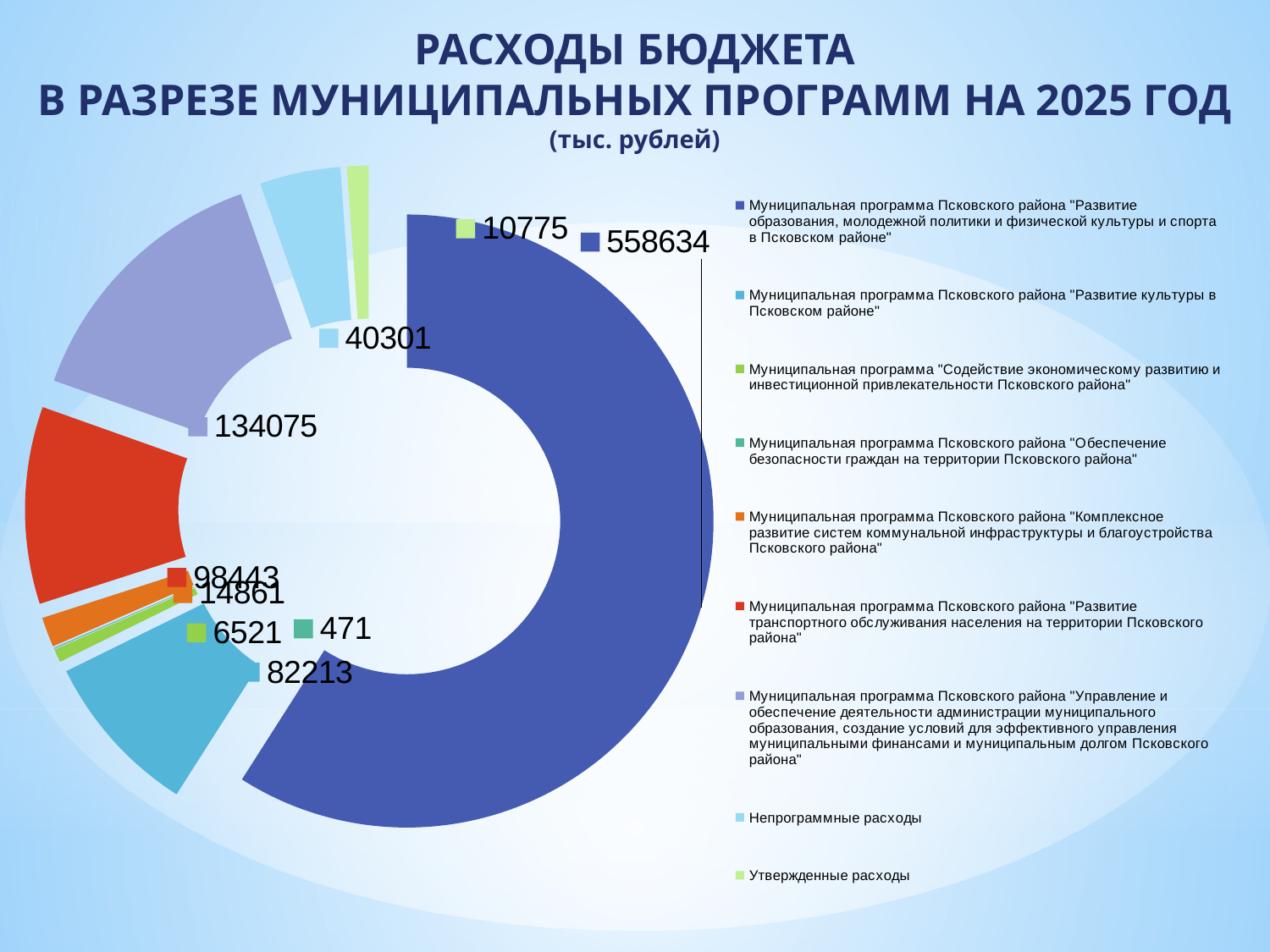
What is the value for "Непрограммные расходы"? 40301 What is the value for the municipal program "Развитие культуры в Псковском районе"? 82213 Which is larger: the value for "Развитие культуры в Псковском районе" or the value for "Непрограммные расходы"? Развитие культуры в Псковском районе How many entries does the legend list? 9 What unit is stated under the chart title? тыс. рублей Which category has the smallest value in the chart? Муниципальная программа Псковского района "Обеспечение безопасности граждан на территории Псковского района" What is the value for the municipal program "Развитие образования, молодежной политики и физической культуры и спорта в Псковском районе"? 558634 Which category has the largest value in the chart? Муниципальная программа Псковского района "Развитие образования, молодежной политики и физической культуры и спорта в Псковском районе" What kind of chart is shown on the slide? Doughnut chart What is the difference between the value for the administration program ("Управление и обеспечение деятельности администрации...") and the transport program ("Развитие транспортного обслуживания населения...")? 35632 What is the value for the municipal program "Обеспечение безопасности граждан на территории Псковского района"? 471 What is the value for "Утвержденные расходы"? 10775